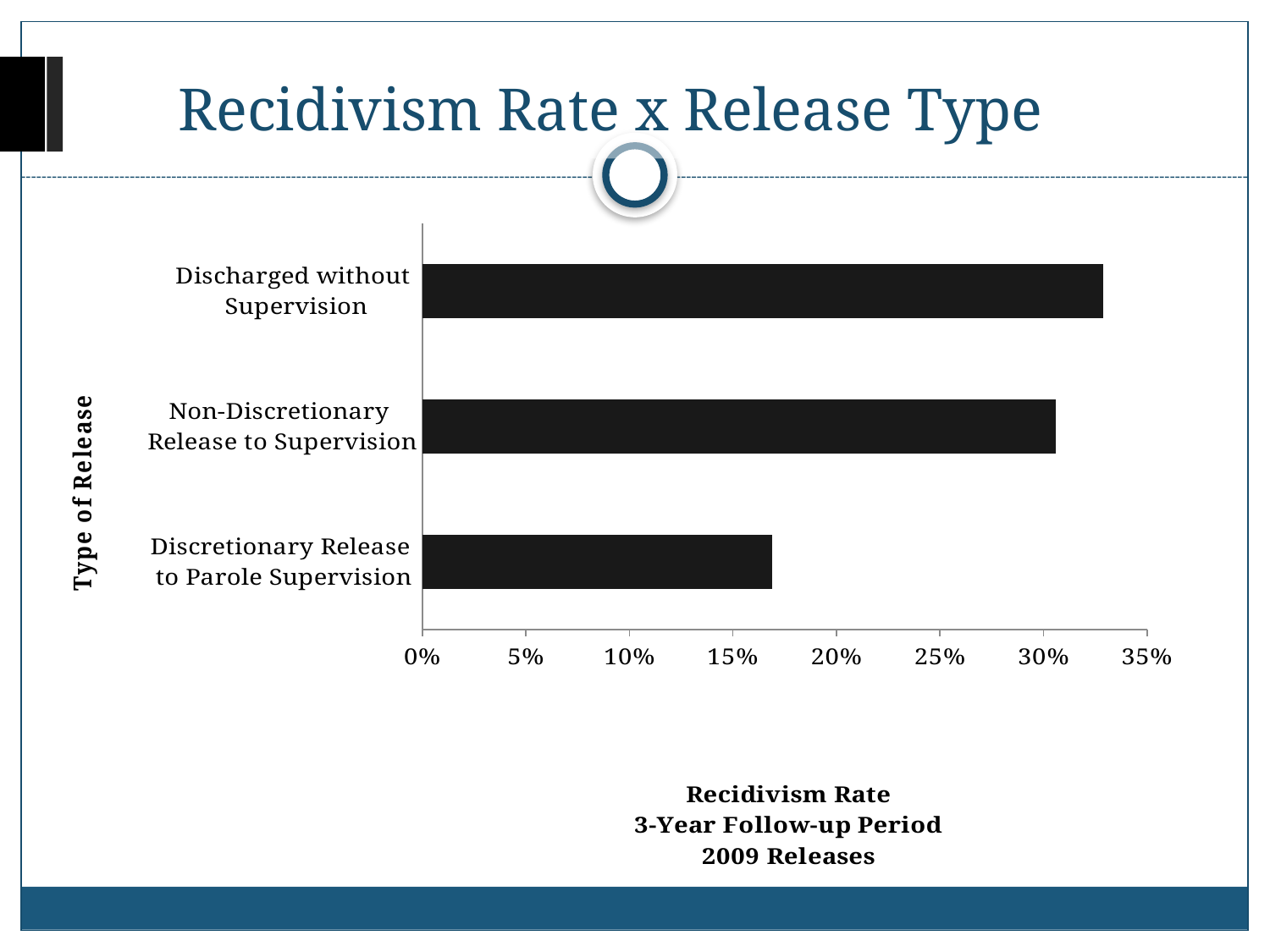
Which release type has the highest recidivism rate? Discharged without Supervision What kind of chart is shown on the slide? bar chart Which has a lower recidivism rate: Discharged without Supervision or Discretionary Release to Parole Supervision? Discretionary Release to Parole Supervision What is the title of the slide's chart? Recidivism Rate x Release Type Is the recidivism rate for Discretionary Release to Parole Supervision greater or less than 20%? less How many release types are plotted in the chart? 3 Which has a higher recidivism rate: Non-Discretionary Release to Supervision or Discretionary Release to Parole Supervision? Non-Discretionary Release to Supervision Which release type has the lowest recidivism rate? Discretionary Release to Parole Supervision Is the recidivism rate for Discretionary Release to Parole Supervision greater or less than 15%? greater What is the label on the vertical axis of the chart? Type of Release Is the recidivism rate for Discharged without Supervision greater or less than 30%? greater